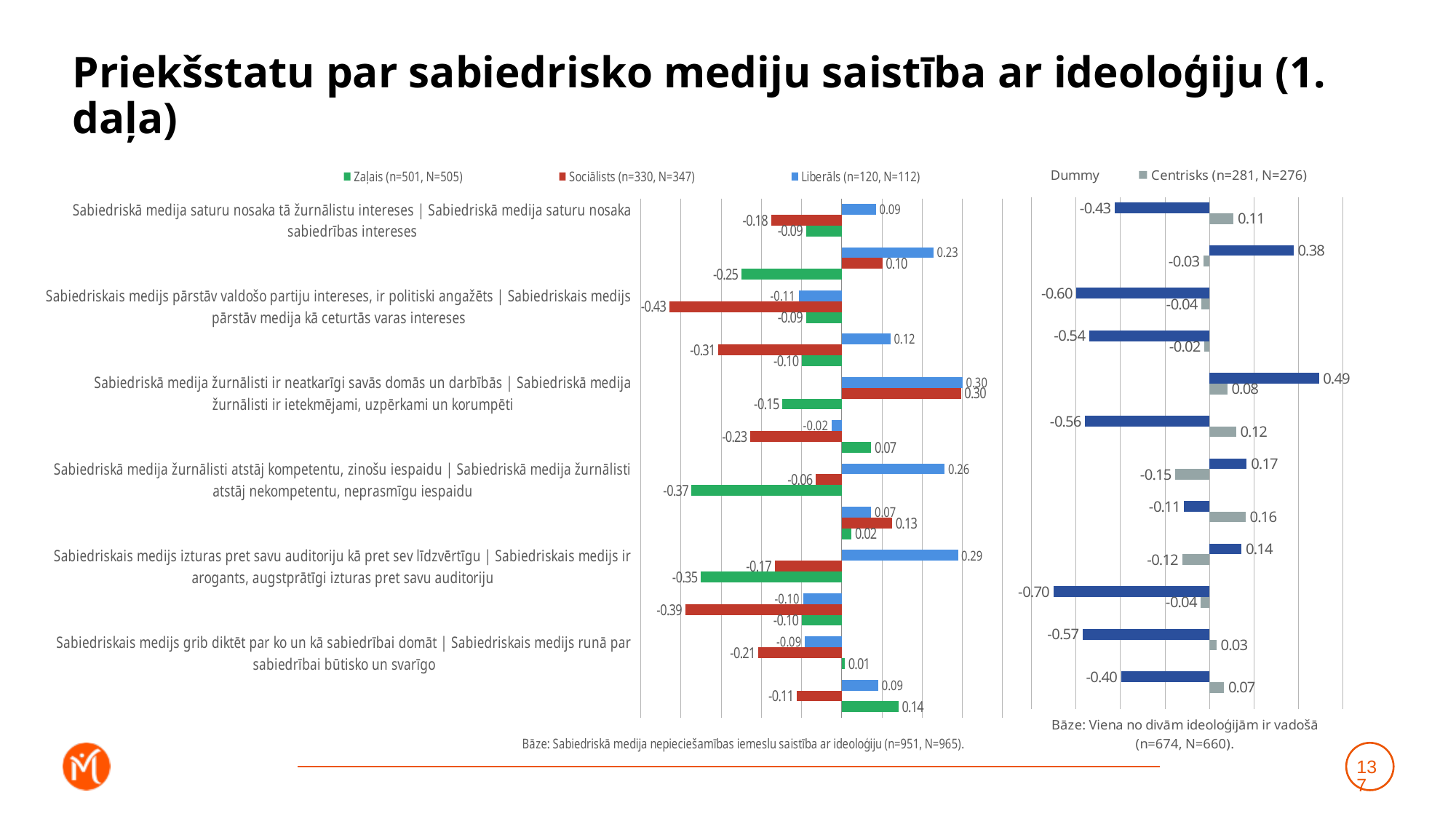
In the left chart, what is the highest value shown for the Liberāls series? 0.30 In the left chart, what is the full legend label of the green series? Zaļais (n=501, N=505) How many series does the legend of the right chart list? 2 In the left chart, what is the highest value shown for the Sociālists series? 0.30 In the left chart, what is the lowest value shown for the Zaļais series? -0.37 How many series does the legend of the left chart list? 3 In the left chart, what is the lowest value shown for the Sociālists series? -0.43 In the right chart, what is the highest value shown for the Centrisks series? 0.16 What kind of chart is used on the left of the slide? bar chart